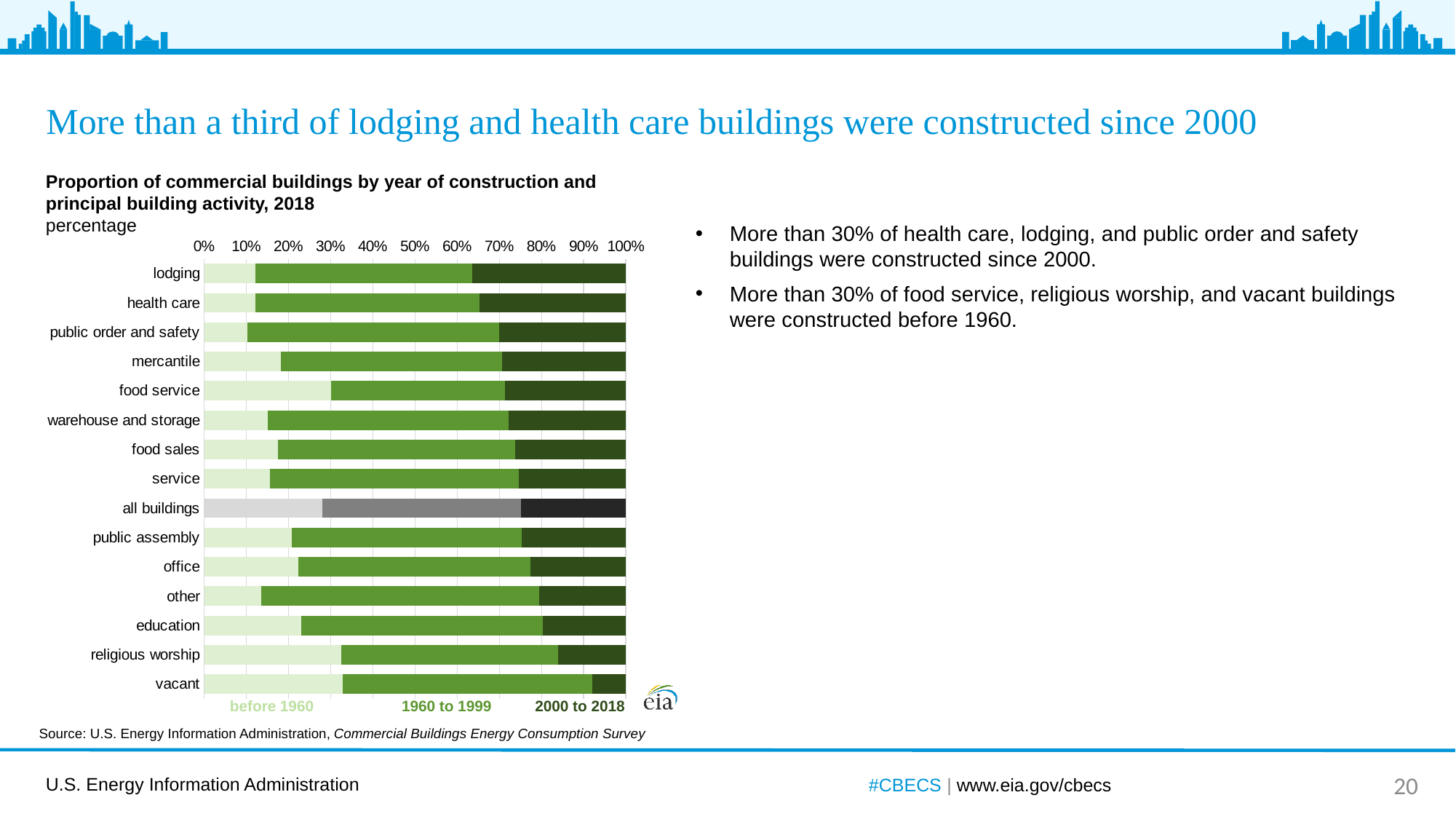
What are the three construction periods shown in the legend? before 1960, 1960 to 1999, 2000 to 2018 How many building activity categories are plotted on the chart? 15 How many series does the chart's legend list? 3 Which has a larger 'before 1960' share, vacant or lodging? vacant Is the 'before 1960' share for health care buildings greater or less than 20%? less Is the 'before 1960' share for lodging buildings greater or less than 20%? less Which building category has the smallest '2000 to 2018' share? vacant Is the 'before 1960' share for vacant buildings greater or less than 30%? greater Which has a larger '2000 to 2018' share, lodging or vacant? lodging What is the title of the chart? Proportion of commercial buildings by year of construction and principal building activity, 2018 What kind of chart is shown on the slide? stacked bar chart